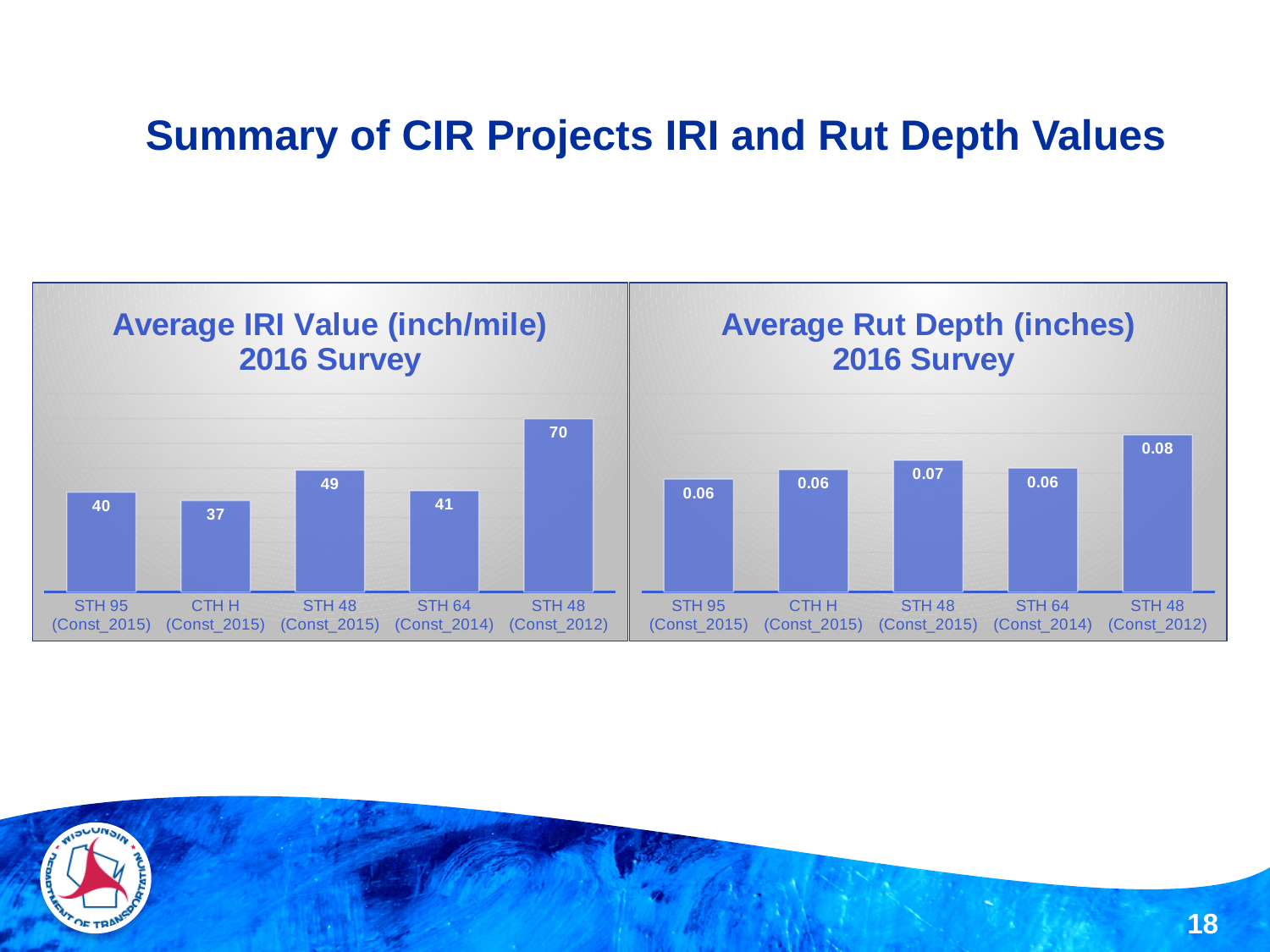
In the Average IRI Value (inch/mile) 2016 Survey chart, what is the value for STH 48 (Const_2012)? 70 What is the title of the chart on the right side of the slide? Average Rut Depth (inches) 2016 Survey What kind of chart is the Average IRI Value (inch/mile) 2016 Survey chart? Bar chart In the Average IRI Value (inch/mile) 2016 Survey chart, what is the difference between STH 48 (Const_2012) and STH 48 (Const_2015)? 21 In the Average IRI Value (inch/mile) 2016 Survey chart, which category has the lowest value? CTH H (Const_2015) How many categories are shown in the Average Rut Depth (inches) 2016 Survey chart? 5 In the Average IRI Value (inch/mile) 2016 Survey chart, which is larger, STH 95 (Const_2015) or STH 64 (Const_2014)? STH 64 (Const_2014) In the Average IRI Value (inch/mile) 2016 Survey chart, which category has the highest value? STH 48 (Const_2012) In the Average Rut Depth (inches) 2016 Survey chart, what is the difference between STH 48 (Const_2012) and STH 95 (Const_2015)? 0.02 In the Average Rut Depth (inches) 2016 Survey chart, which category has the highest value? STH 48 (Const_2012) In the Average IRI Value (inch/mile) 2016 Survey chart, what is the value for CTH H (Const_2015)? 37 In the Average Rut Depth (inches) 2016 Survey chart, what is the value for STH 48 (Const_2015)? 0.07